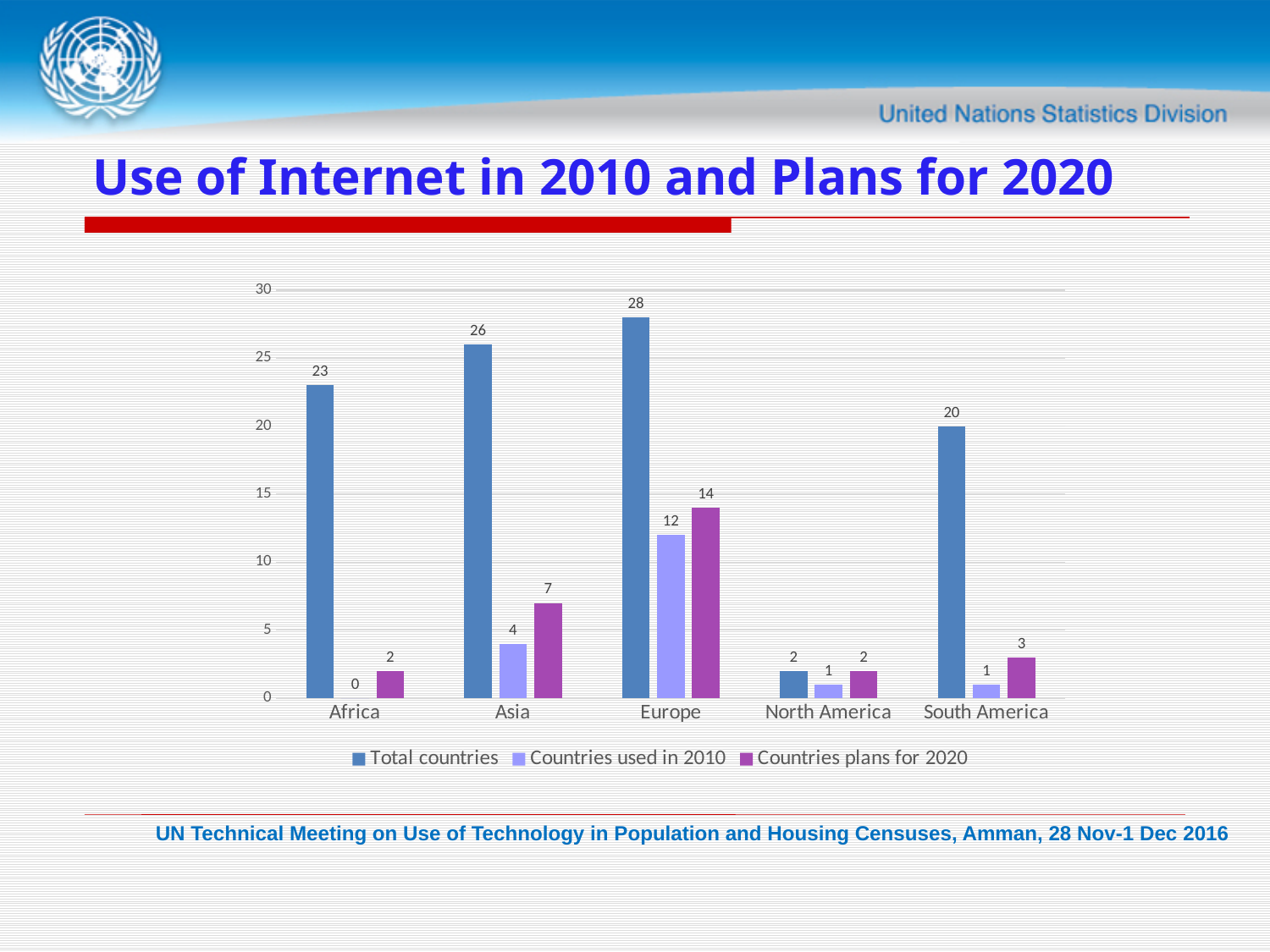
What is the title of the slide? Use of Internet in 2010 and Plans for 2020 Which region has the lowest value for Countries used in 2010? Africa How many series does the legend list? 3 What is the value of Countries plans for 2020 for South America? 3 What kind of chart is shown on the slide? Bar chart What is the difference between Total countries and Countries plans for 2020 for Europe? 14 What is the difference between Total countries for Africa and Total countries for South America? 3 How many regions are shown on the x axis? 5 Which region has the highest value for Total countries? Europe Which is larger for Asia: Countries used in 2010 or Countries plans for 2020? Countries plans for 2020 How many countries in Asia used the Internet in 2010? 4 What is the value of Total countries for Europe? 28